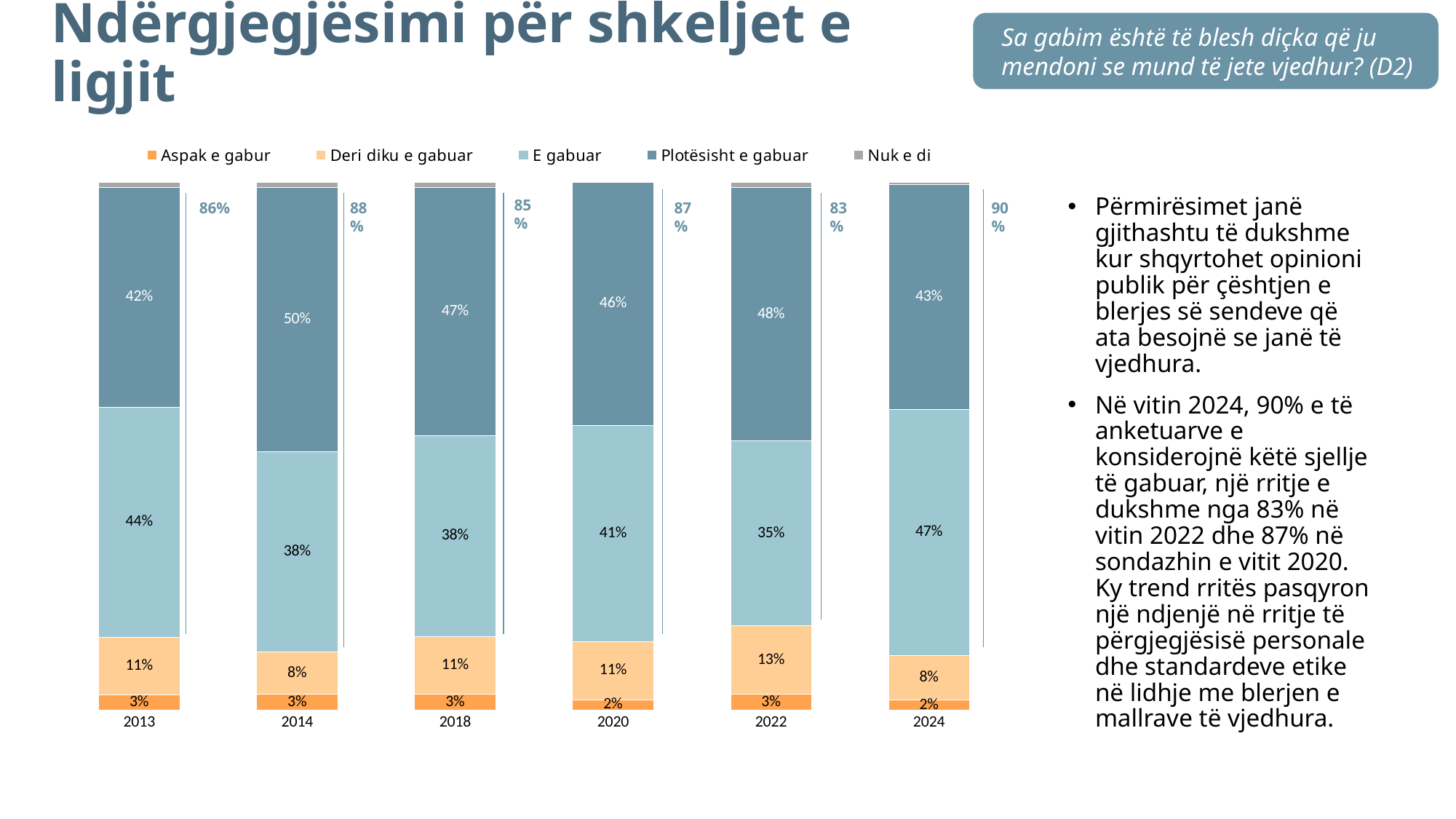
Which is larger: the 'Deri diku e gabuar' value in 2013 or in 2014? 2013 In which year is the 'Plotësisht e gabuar' value highest? 2014 What is the difference between the 'E gabuar' values for 2024 and 2022? 12% In which year is the 'E gabuar' value lowest? 2022 How many years are shown on the x axis? 6 What combined percentage is shown beside the 2024 bar? 90% How many series does the legend list? 5 What is the value for 'Plotësisht e gabuar' in 2014? 50% What kind of chart is shown on the slide? Stacked bar chart What is the value for 'E gabuar' in 2024? 47% What is the value for 'Deri diku e gabuar' in 2022? 13% What is the value for 'Aspak e gabur' in 2020? 2%